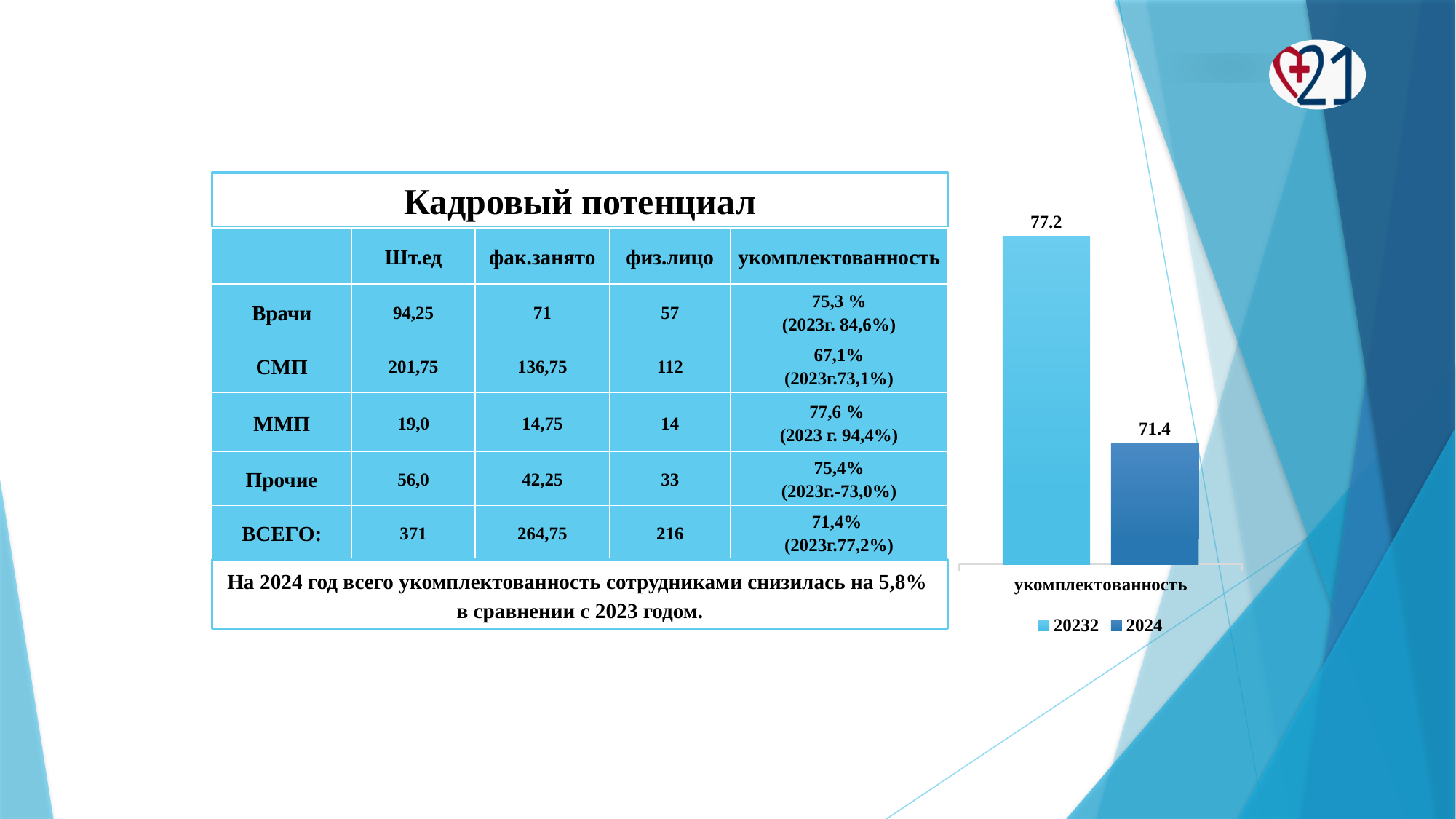
How many categories are shown on the x axis of the bar chart? 1 What type of chart is shown on the right of the slide? bar chart In the bar chart, what is the value of the bar for the series labelled 20232 in the legend? 77.2 What are the two legend entries of the bar chart? 20232 and 2024 In the bar chart, what is the value of the bar for the series labelled 2024? 71.4 What is the category label on the x axis of the bar chart? укомплектованность In the bar chart, does the value fall or rise from the 20232 bar to the 2024 bar? fall How many series does the legend of the bar chart list? 2 In the bar chart, what is the difference between the 20232 bar and the 2024 bar? 5.8 In the bar chart, which series has the higher bar, 20232 or 2024? 20232 In the bar chart, which series has the lowest value? 2024 In the bar chart, which series has the highest value? 20232